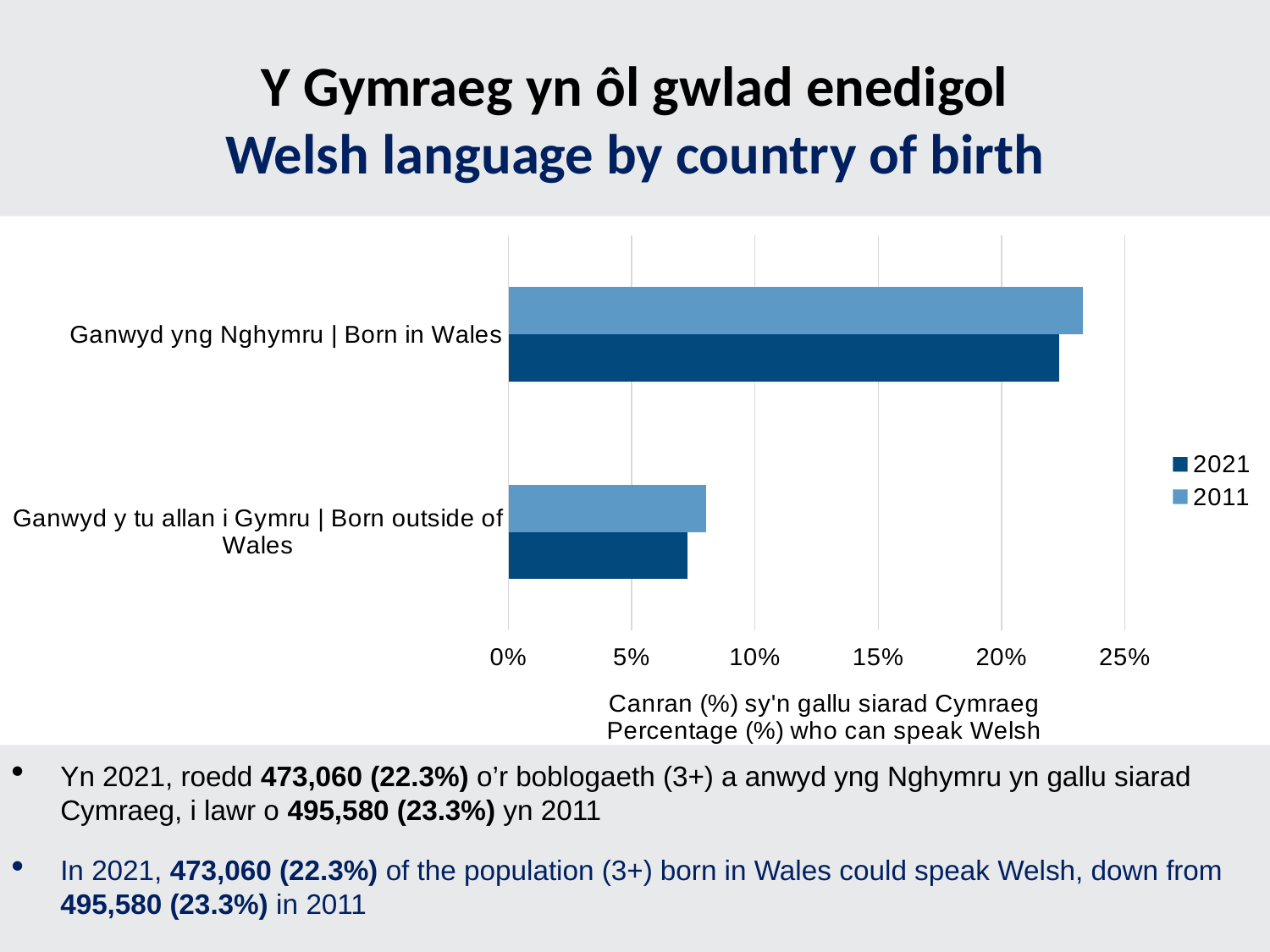
Is the 2011 value for Born outside of Wales greater or less than 5%? greater How many categories are shown on the chart? 2 Is the 2021 value for Born outside of Wales greater or less than 10%? less What percentage of the population born in Wales could speak Welsh in 2011? 23.3% Which category has the highest percentage who can speak Welsh in 2021? Ganwyd yng Nghymru | Born in Wales What kind of chart is shown on the slide? bar chart How many series does the legend list? 2 Which category has the lowest percentage who can speak Welsh in 2011? Ganwyd y tu allan i Gymru | Born outside of Wales Is the 2021 value for Born in Wales greater or less than 20%? greater What percentage of the population born in Wales could speak Welsh in 2021? 22.3% What is the title of the horizontal axis in English? Percentage (%) who can speak Welsh For Born in Wales, which year has the larger percentage who can speak Welsh, 2011 or 2021? 2011